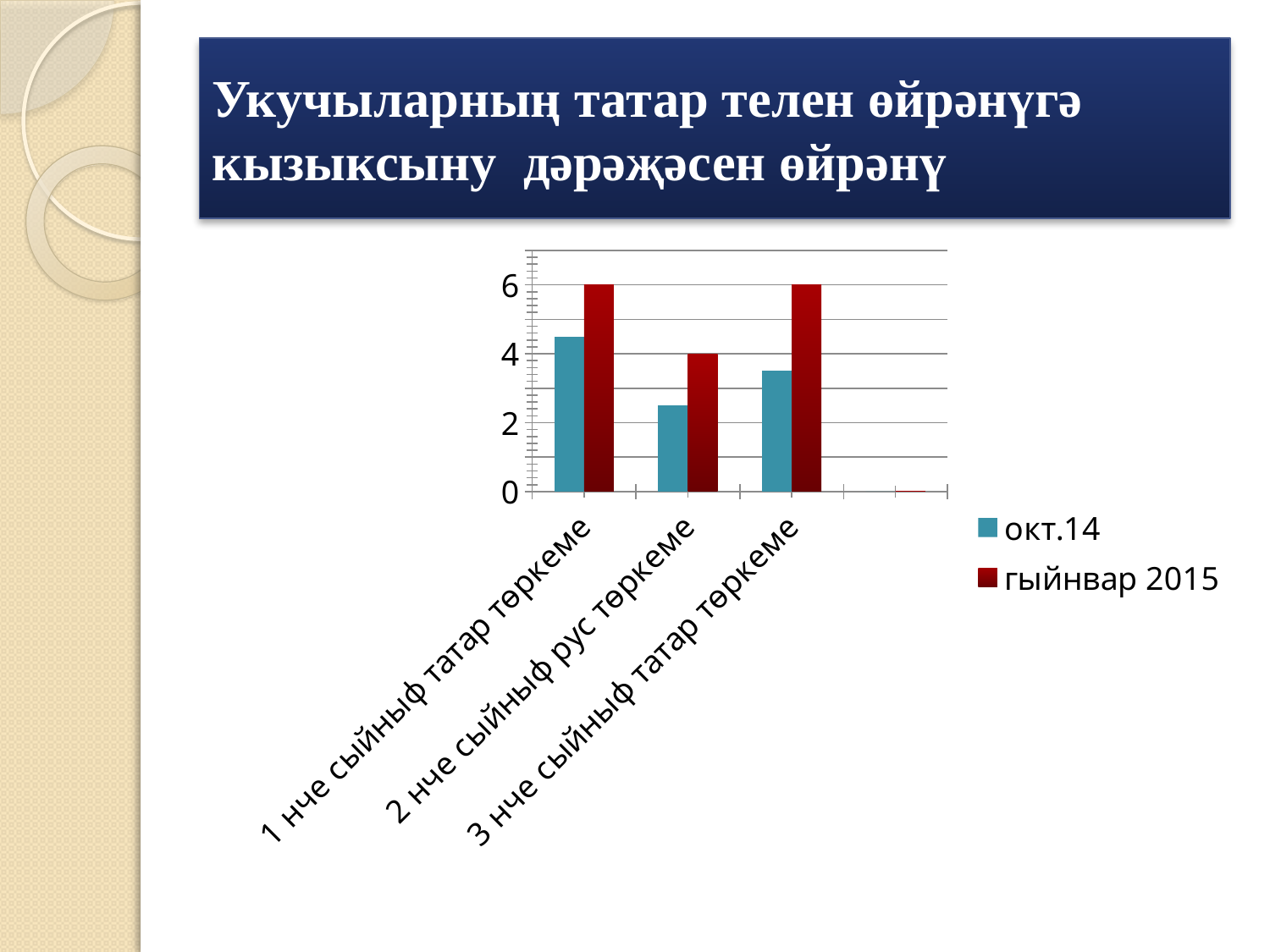
How many series does the legend list? 2 Is the окт.14 value for 2 нче сыйныф рус төркеме greater or less than 2? greater Which category has the lowest окт.14 value? 2 нче сыйныф рус төркеме Is the окт.14 value for 3 нче сыйныф татар төркеме greater or less than 4? less What is the гыйнвар 2015 value for 1 нче сыйныф татар төркеме? 6 Is the окт.14 value for 1 нче сыйныф татар төркеме greater or less than 4? greater What kind of chart is shown on the slide? bar chart What is the гыйнвар 2015 value for 3 нче сыйныф татар төркеме? 6 What is the гыйнвар 2015 value for 2 нче сыйныф рус төркеме? 4 What is the difference between the гыйнвар 2015 values for 1 нче сыйныф татар төркеме and 2 нче сыйныф рус төркеме? 2 Which category has the lowest гыйнвар 2015 value? 2 нче сыйныф рус төркеме For 2 нче сыйныф рус төркеме, which series has the larger value, окт.14 or гыйнвар 2015? гыйнвар 2015